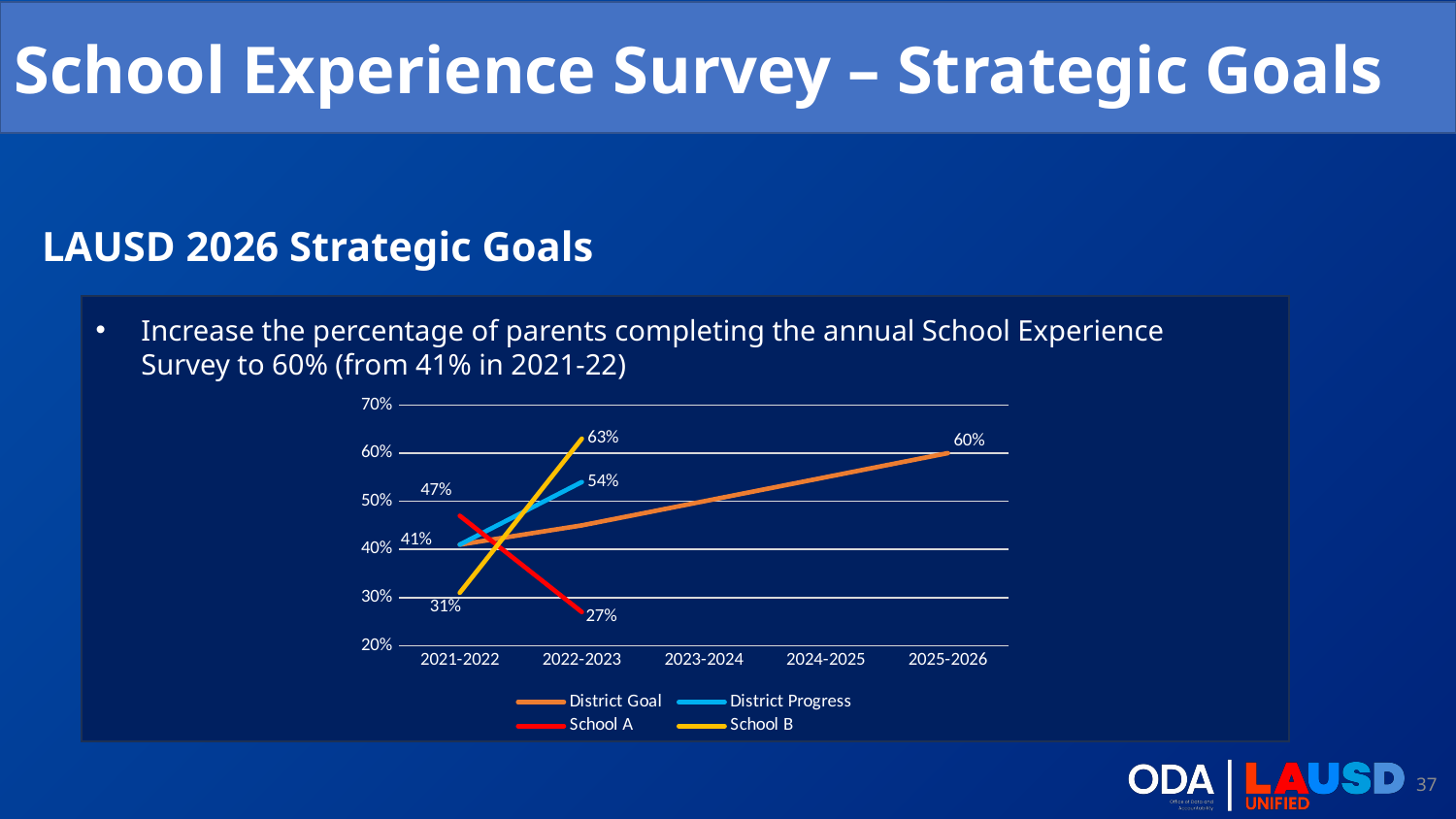
Does the School A line rise or fall from 2021-2022 to 2022-2023? fall What is the District Goal value for 2025-2026? 60% How many school years are shown on the x axis of the chart? 5 What is the School B value for 2022-2023? 63% Which series is drawn in red on the chart? School A What is the District Progress value for 2022-2023? 54% By how many percentage points does School B change from 2021-2022 to 2022-2023? 32% What is the School A value for 2021-2022? 47% How many series does the chart legend list? 4 What is the School B value for 2021-2022? 31% What kind of chart is shown on the slide? line chart Which is larger in 2022-2023, the School B value or the District Progress value? School B